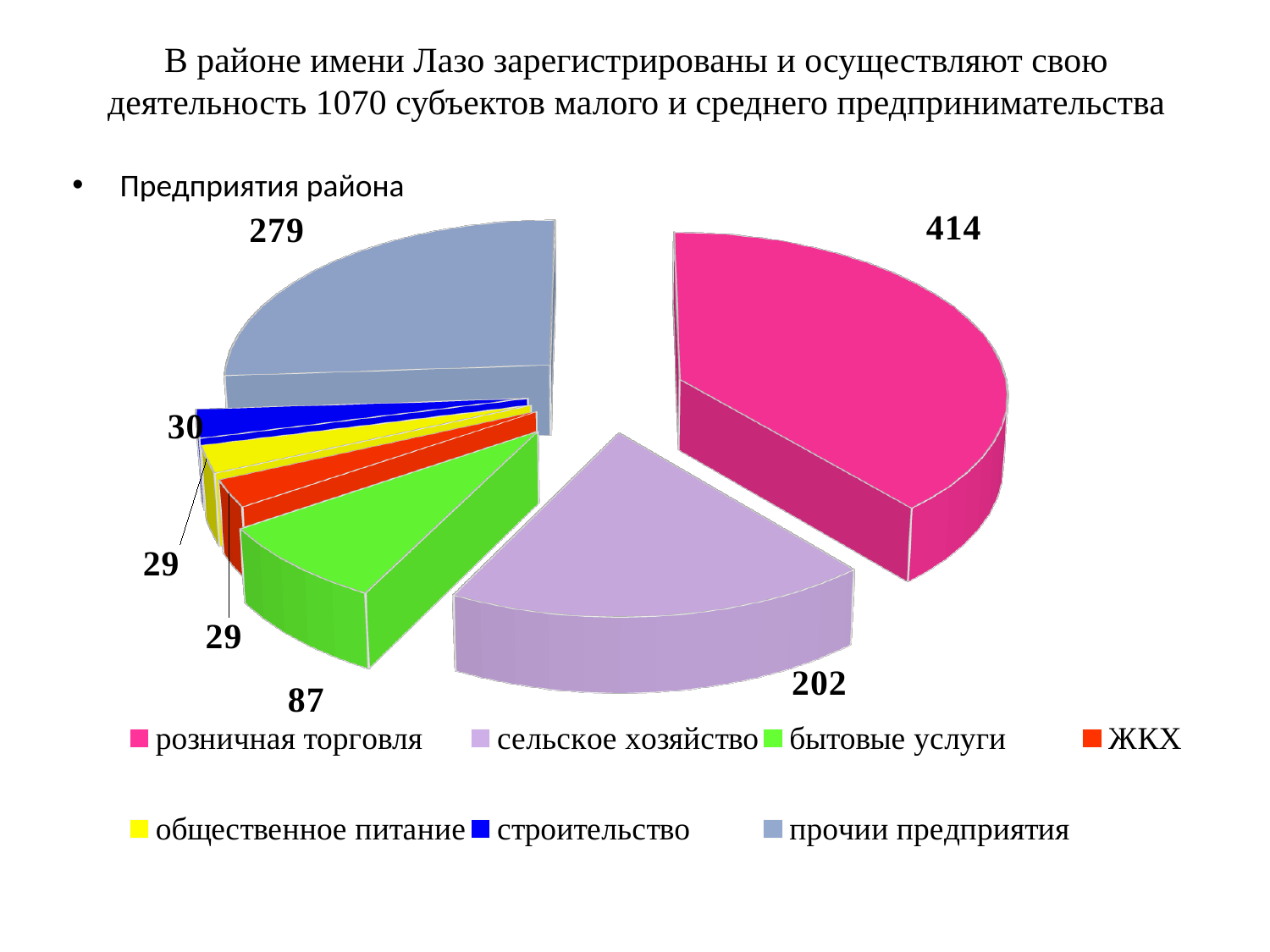
What is the value for строительство? 30 What is the value for прочии предприятия? 279 What is the difference between the values for прочии предприятия and бытовые услуги? 192 What kind of chart is shown on the slide? pie chart What is the value for бытовые услуги? 87 What is the difference between the values for розничная торговля and сельское хозяйство? 212 How many categories does the pie chart have? 7 What is the value for розничная торговля? 414 What is the value for сельское хозяйство? 202 Which is larger, сельское хозяйство or прочии предприятия? прочии предприятия Which category has the largest slice of the pie? розничная торговля